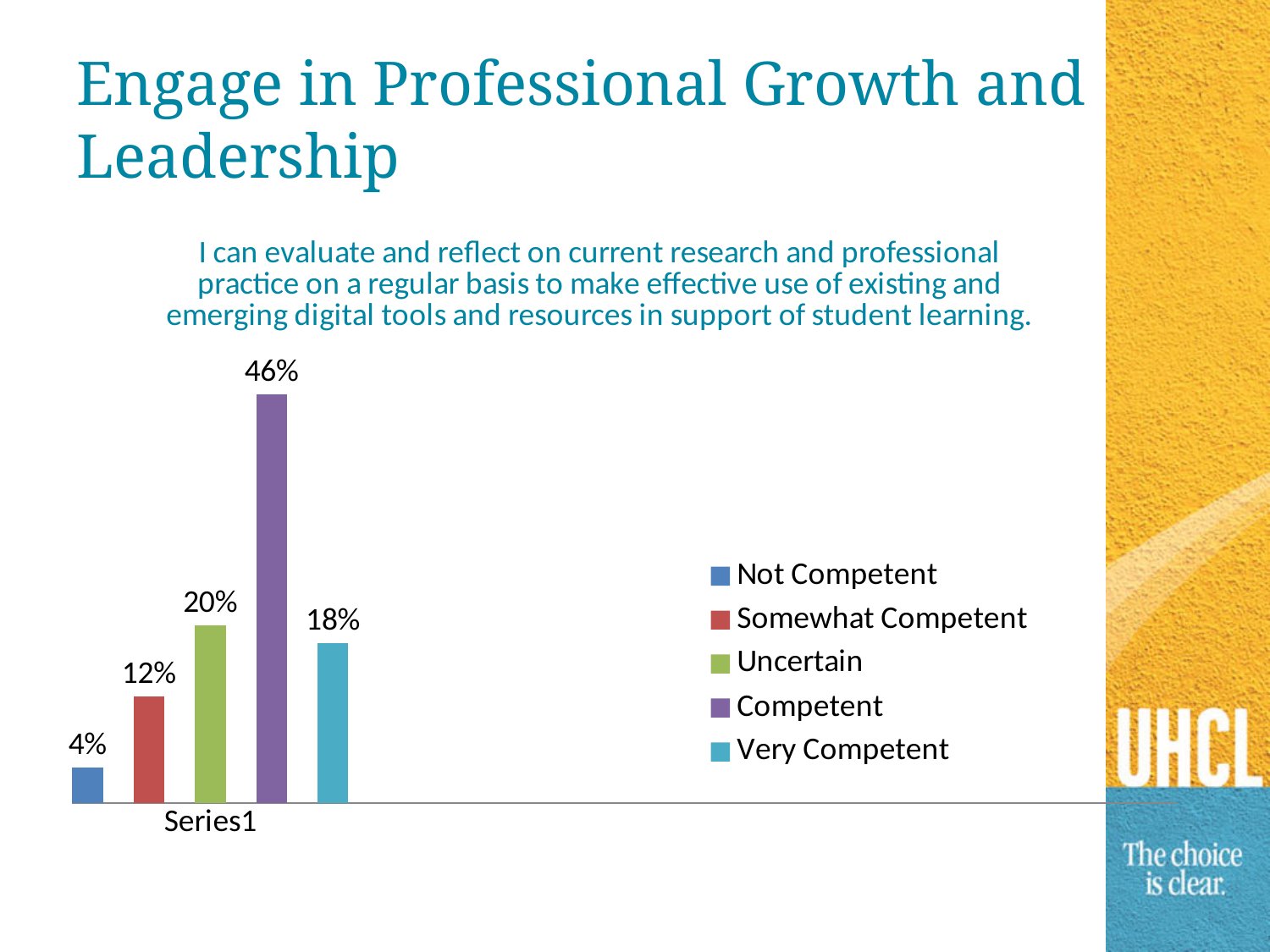
What colour is the bar for Competent? Purple What percentage of respondents answered Not Competent? 4% Which response category has the lowest percentage? Not Competent Which response category has the highest percentage? Competent What percentage of respondents answered Uncertain? 20% How many series does the legend list? 5 What kind of chart is shown on the slide? Bar chart What percentage of respondents answered Very Competent? 18% What is the difference between the Uncertain and Somewhat Competent percentages? 8% What percentage of respondents answered Competent? 46% Which is larger, the percentage for Uncertain or for Very Competent? Uncertain What is the difference between the Competent and Very Competent percentages? 28%